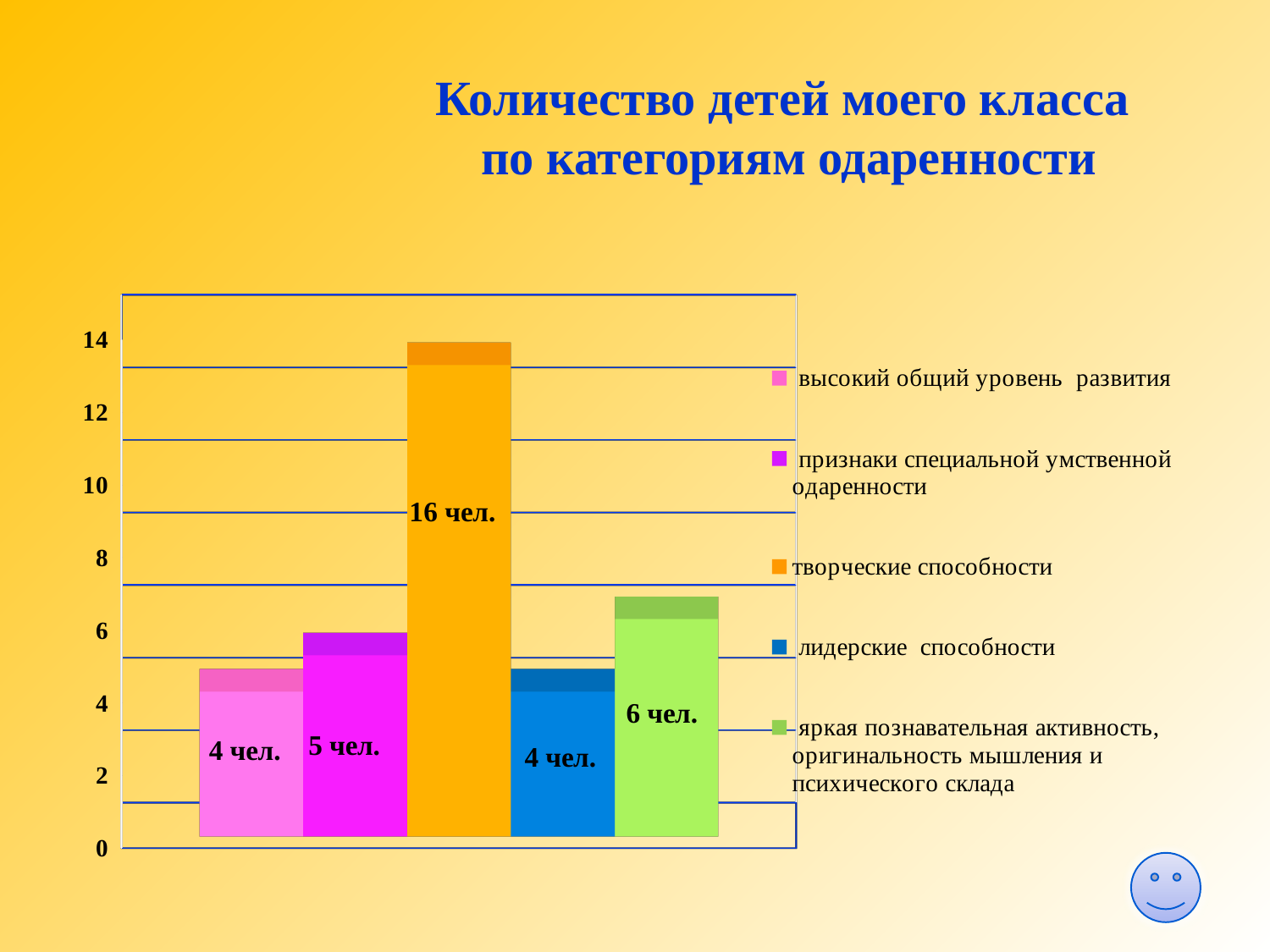
What value is shown for the bar 'признаки специальной умственной одаренности'? 5 чел. What value is shown for the bar 'лидерские способности'? 4 чел. What value is shown for the bar 'творческие способности'? 16 чел. Which is larger: the value for 'признаки специальной умственной одаренности' or the value for 'лидерские способности'? признаки специальной умственной одаренности How many entries does the legend list? 5 Which category has the highest value? творческие способности What value is shown for the bar 'высокий общий уровень развития'? 4 чел. Is the value for 'творческие способности' greater or less than 10? greater What is the difference between the values for 'творческие способности' and 'яркая познавательная активность, оригинальность мышления и психического склада'? 10 чел. What value is shown for the bar 'яркая познавательная активность, оригинальность мышления и психического склада'? 6 чел. How many bars are plotted in the chart? 5 What kind of chart is shown on the slide? bar chart